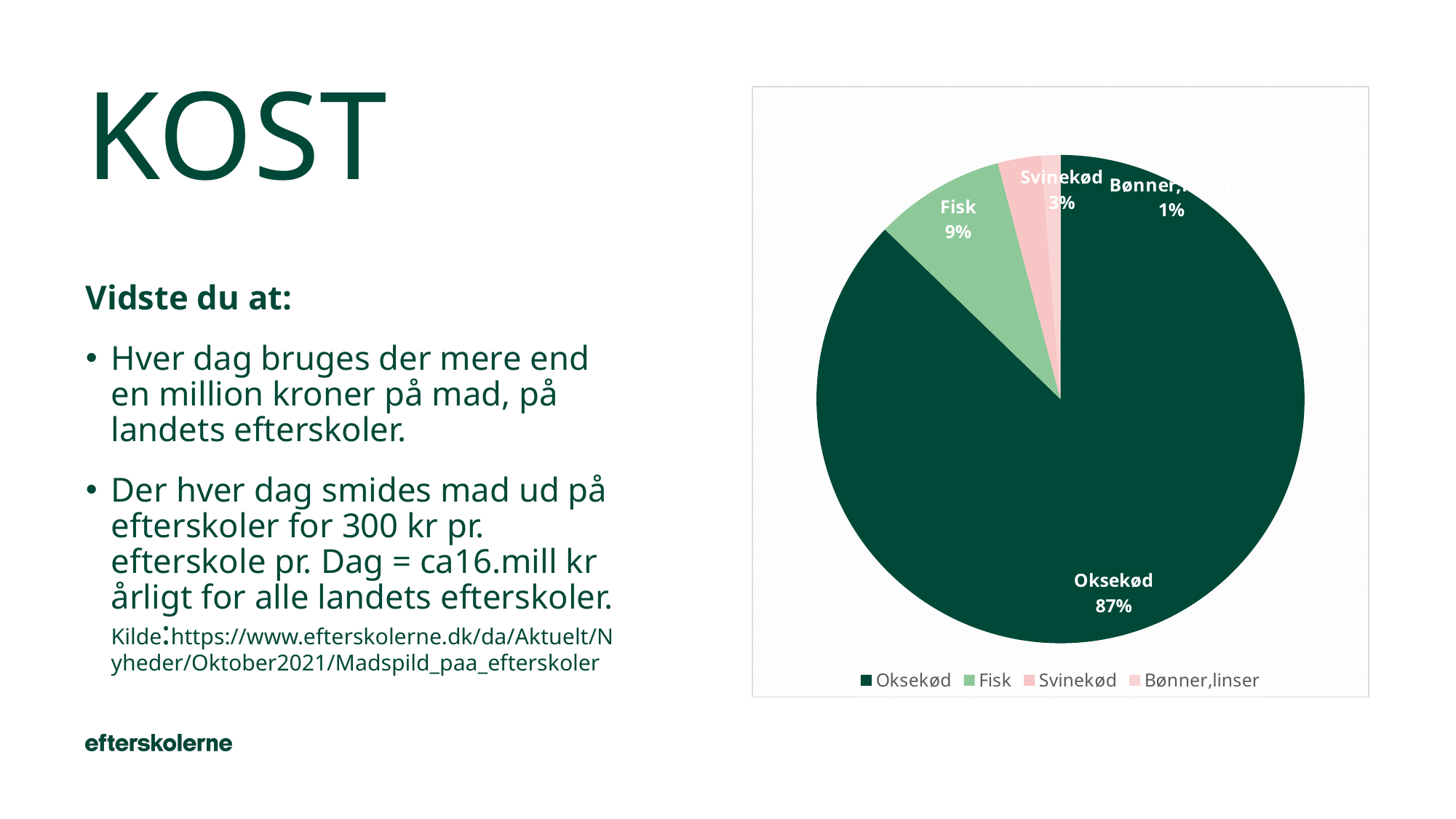
What is the difference in percentage points between Svinekød and Bønner,linser? 2 What is the difference in percentage points between Oksekød and Fisk? 78 What kind of chart is shown on the slide? pie chart Which category has the largest slice of the pie? Oksekød How many categories does the pie chart show? 4 What share of the pie does Bønner,linser have? 1% What share of the pie does Fisk have? 9% Which is larger, the share for Fisk or the share for Svinekød? Fisk What share of the pie does Svinekød have? 3% Which category has the smallest slice of the pie? Bønner,linser How many entries does the legend list? 4